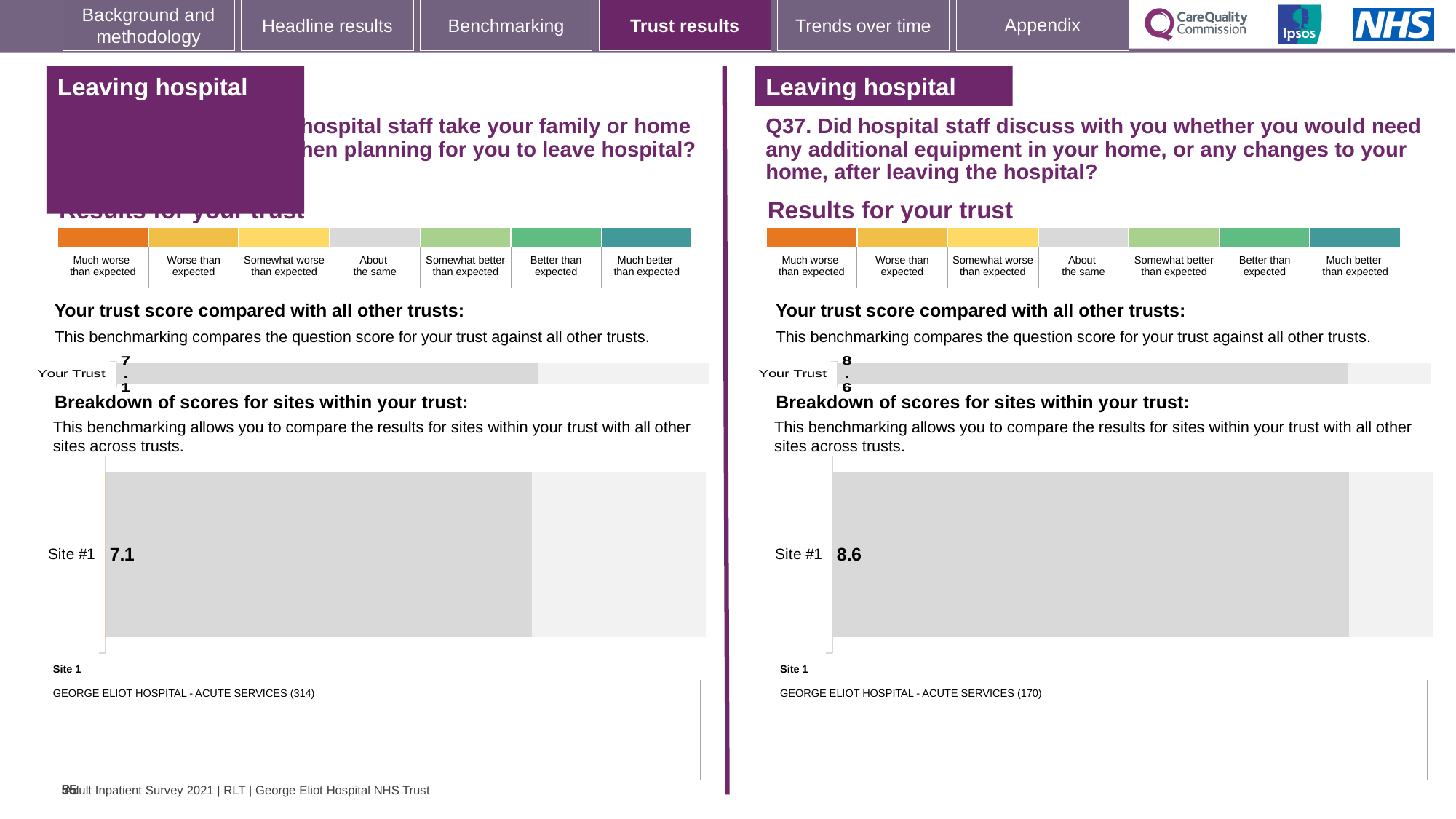
What number appears in parentheses after the Site 1 name beneath the left-hand breakdown chart? 314 On the right-hand 'Breakdown of scores for sites within your trust' chart (Q37), what is the score for Site #1? 8.6 How many sites are shown on the left-hand 'Breakdown of scores for sites within your trust' chart? 1 Is the Site #1 score on the right-hand breakdown chart greater or less than 8? greater Comparing the Site #1 scores on the left-hand and right-hand breakdown charts, which chart shows the larger value? The right-hand chart (Q37) What is the difference between the Site #1 score on the right-hand chart (8.6) and the Site #1 score on the left-hand chart (7.1)? 1.5 On the right-hand 'Your trust score compared with all other trusts' chart (Q37), what is the value shown for Your Trust? 8.6 What type of chart is used for the 'Breakdown of scores for sites within your trust' on the right-hand side? Bar chart Which site is listed as Site 1 beneath the right-hand breakdown chart? GEORGE ELIOT HOSPITAL - ACUTE SERVICES (170) On the left-hand 'Your trust score compared with all other trusts' chart, what is the value shown for Your Trust? 7.1 On the left-hand 'Breakdown of scores for sites within your trust' chart, what is the score for Site #1? 7.1 How many sites are shown on the right-hand 'Breakdown of scores for sites within your trust' chart? 1